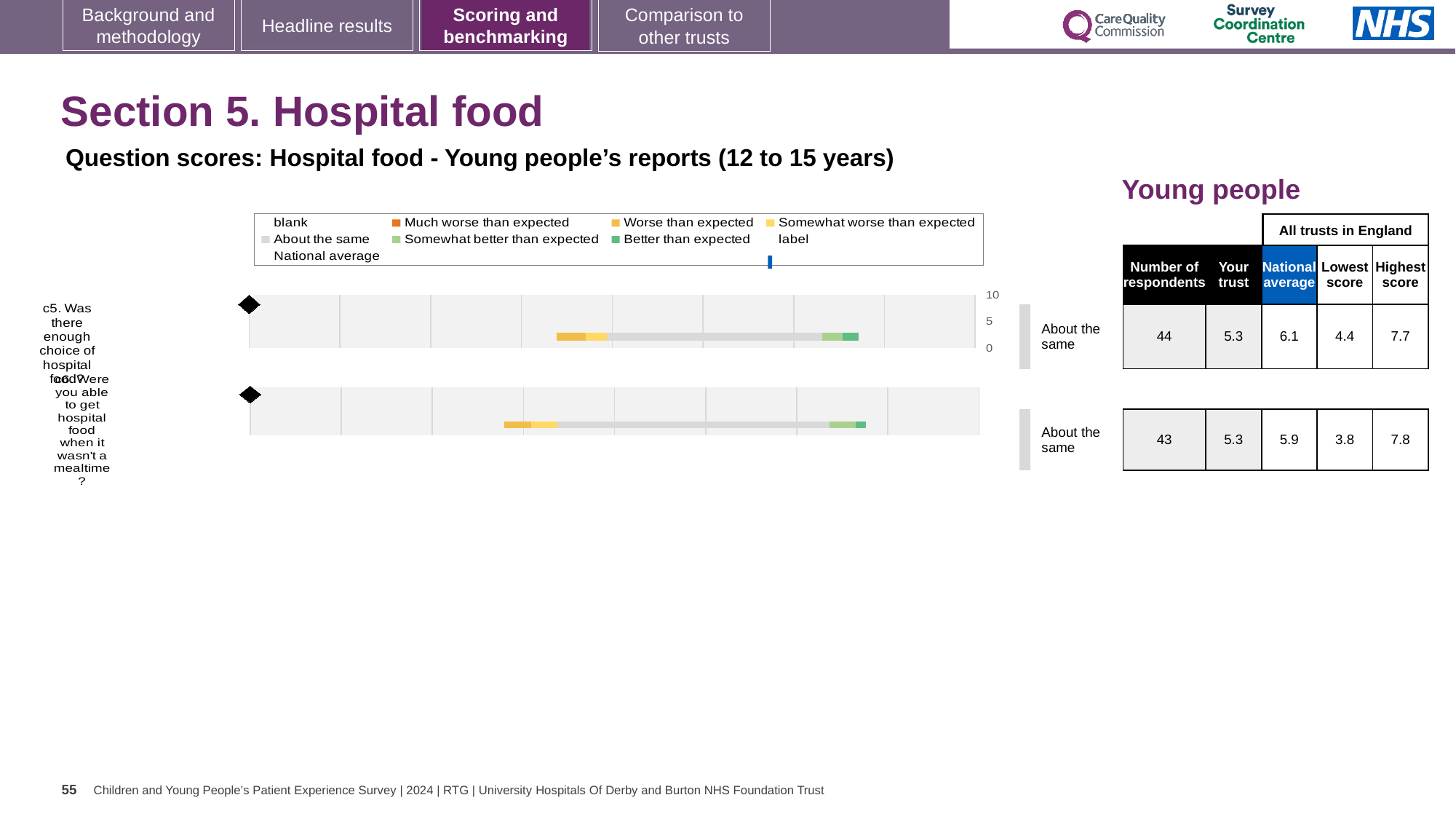
What is the 'Your trust' score for question c5 (Was there enough choice of hospital food?)? 5.3 How many survey questions are plotted in the hospital food chart? 2 How many more respondents answered question c5 than question c6? 1 What is the difference between the highest score and the lowest score for question c5? 3.3 Which question has the higher national average, c5 or c6? c5 What is the national average score for question c6 (Were you able to get hospital food when it wasn't a mealtime?)? 5.9 What is the maximum value shown on the chart's score axis? 10 Which question has the higher 'Highest score' across all trusts in England? c6 How many respondents answered question c5? 44 What kind of chart is used to show the question scores for hospital food? Bar chart What benchmark category is shown for question c5? About the same What is the lowest score across all trusts in England for question c6? 3.8